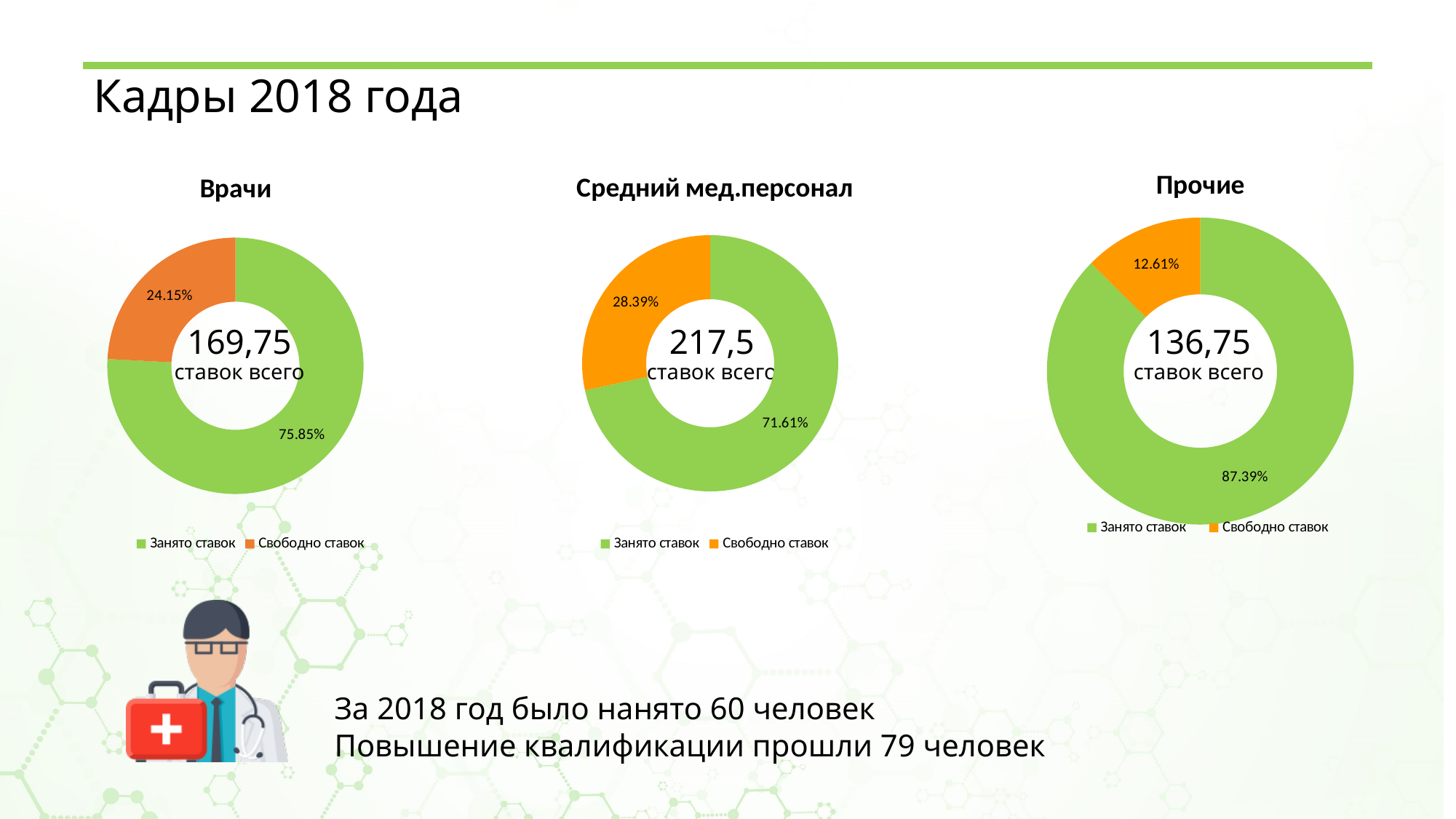
What total number of positions ('ставок всего') is shown in the centre of the 'Прочие' chart? 136,75 In the 'Врачи' chart, which slice is larger: 'Занято ставок' or 'Свободно ставок'? Занято ставок In the 'Прочие' chart, what percentage is shown for 'Свободно ставок'? 12.61% In the 'Средний мед.персонал' chart, what is the difference in percentage points between 'Занято ставок' and 'Свободно ставок'? 43.22 How many entries does the legend of the 'Прочие' chart list? 2 In the 'Врачи' chart, what percentage of positions is shown for 'Занято ставок'? 75.85% What type of chart is used for 'Врачи', 'Средний мед.персонал' and 'Прочие'? Pie (donut) chart In the 'Прочие' chart, what percentage is shown for 'Занято ставок'? 87.39% In the 'Средний мед.персонал' chart, what percentage is shown for 'Свободно ставок'? 28.39% What total number of positions ('ставок всего') is shown in the centre of the 'Средний мед.персонал' chart? 217,5 In the 'Врачи' chart, what percentage is shown for 'Свободно ставок'? 24.15% In the 'Средний мед.персонал' chart, what percentage is shown for 'Занято ставок'? 71.61%